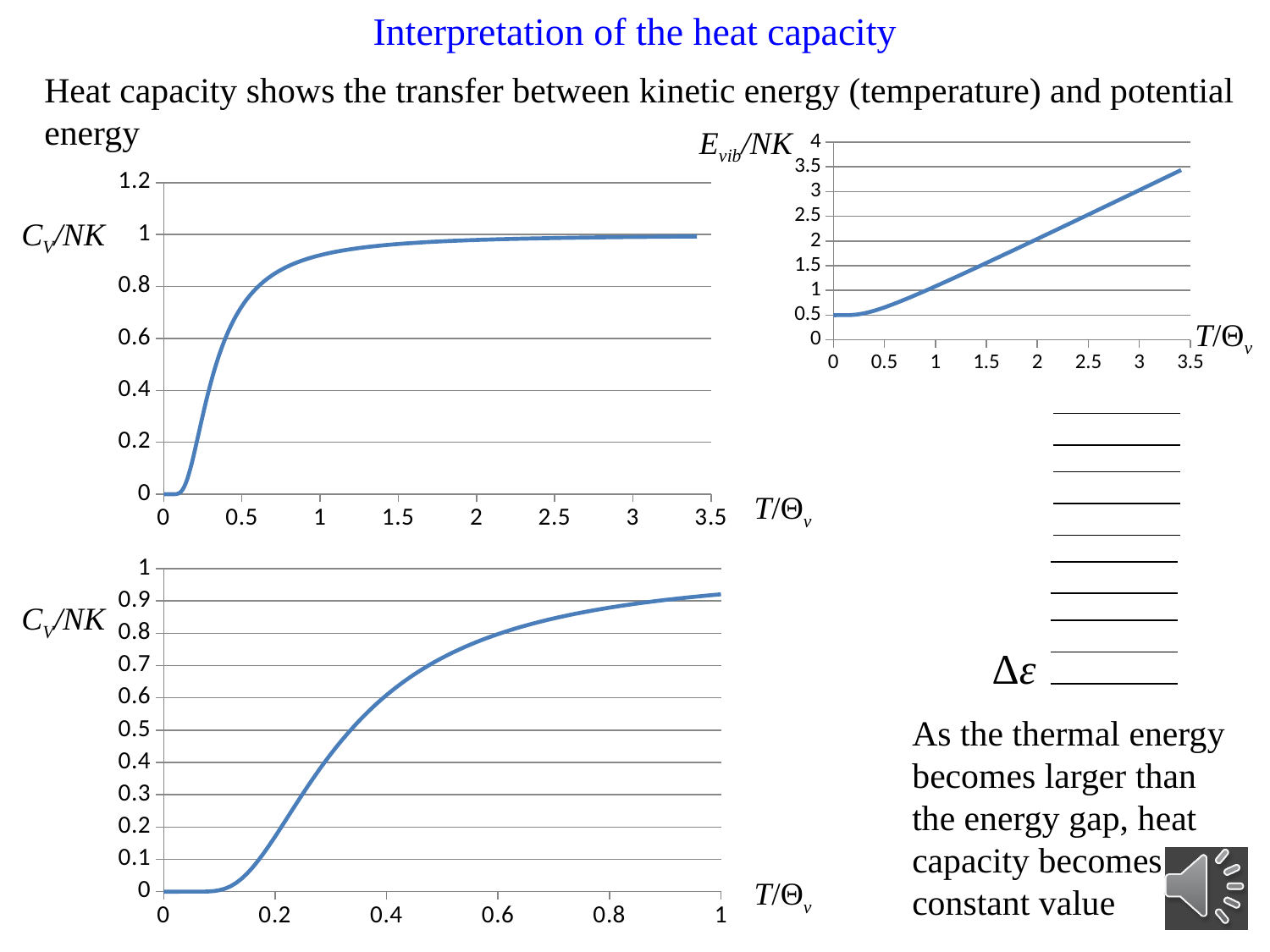
In the top-left chart (C_V/NK, x axis 0 to 3.5), which is larger: the value at T/Θ_v = 1 or the value at T/Θ_v = 0.2? T/Θ_v = 1 What is the highest tick value shown on the y axis of the top-left chart (C_V/NK, x axis 0 to 3.5)? 1.2 In the top-left chart (C_V/NK, x axis 0 to 3.5), is the value at T/Θ_v = 0.1 greater or less than 0.2? less In the top-right chart (E_vib/NK), is the value at T/Θ_v = 0.5 greater or less than 1? less In the top-left chart (C_V/NK, x axis 0 to 3.5), do the values rise or fall as T/Θ_v increases? rise In the top-right chart (E_vib/NK versus T/Θ_v), do the values rise or fall as T/Θ_v increases? rise In the top-left chart (C_V/NK, x axis 0 to 3.5), is the value at T/Θ_v = 3 greater or less than 0.8? greater What kind of chart is the top-left chart (C_V/NK versus T/Θ_v, x axis 0 to 3.5)? line chart What kind of chart is the bottom-left chart (C_V/NK versus T/Θ_v, x axis 0 to 1)? line chart